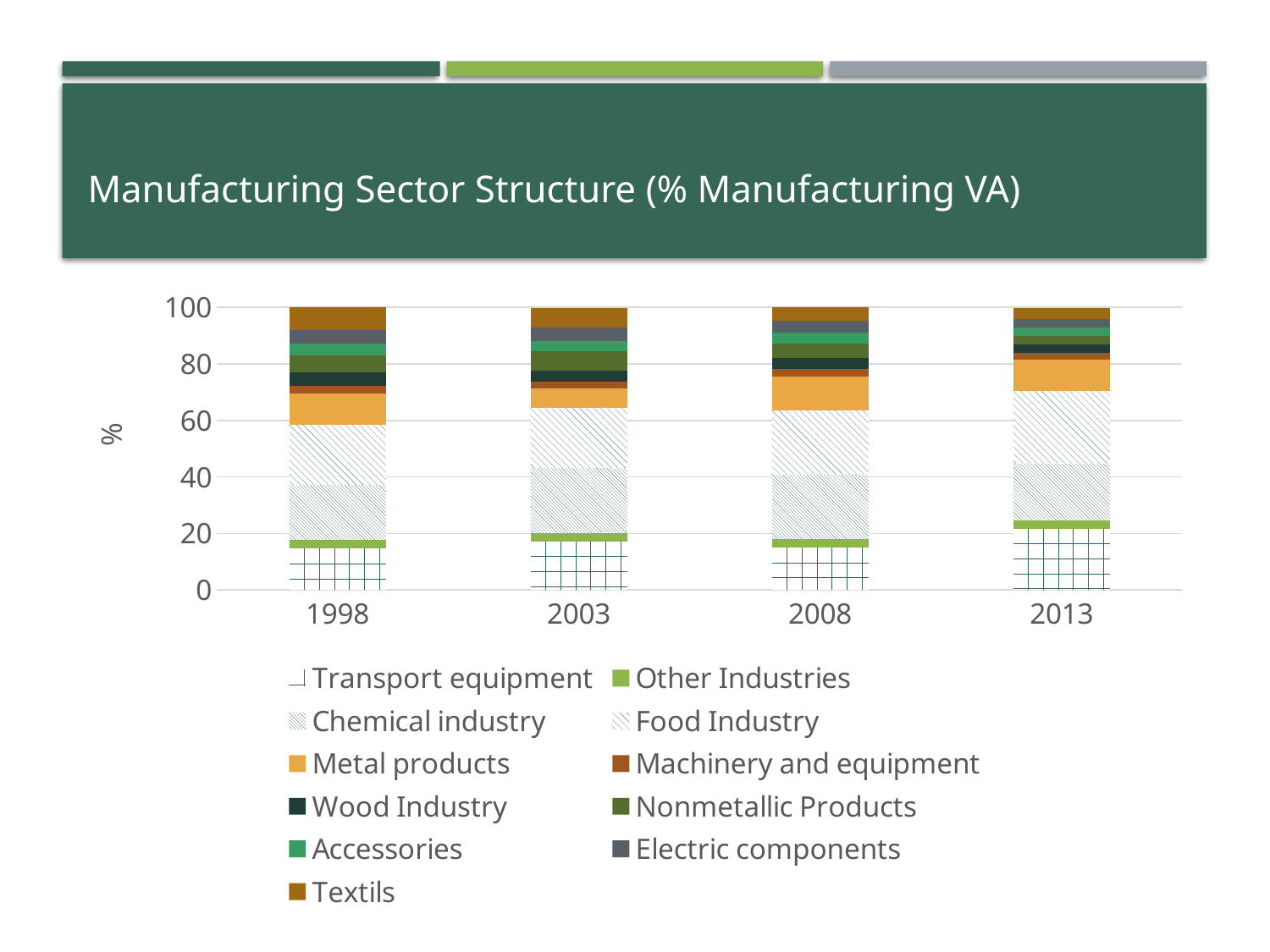
Is the Transport equipment segment for 2008 greater or less than 20? less Is the Transport equipment segment for 1998 greater or less than 20? less How many series does the chart's legend list? 11 What kind of chart is shown on the slide? stacked bar chart Which year has the largest Transport equipment segment? 2013 What is the title of the chart on the slide? Manufacturing Sector Structure (% Manufacturing VA) Is the Transport equipment segment larger in 1998 or in 2013? 2013 What label is shown on the y axis of the chart? % How many years are shown on the x axis of the chart? 4 Is the Transport equipment segment for 2013 greater or less than 20? greater